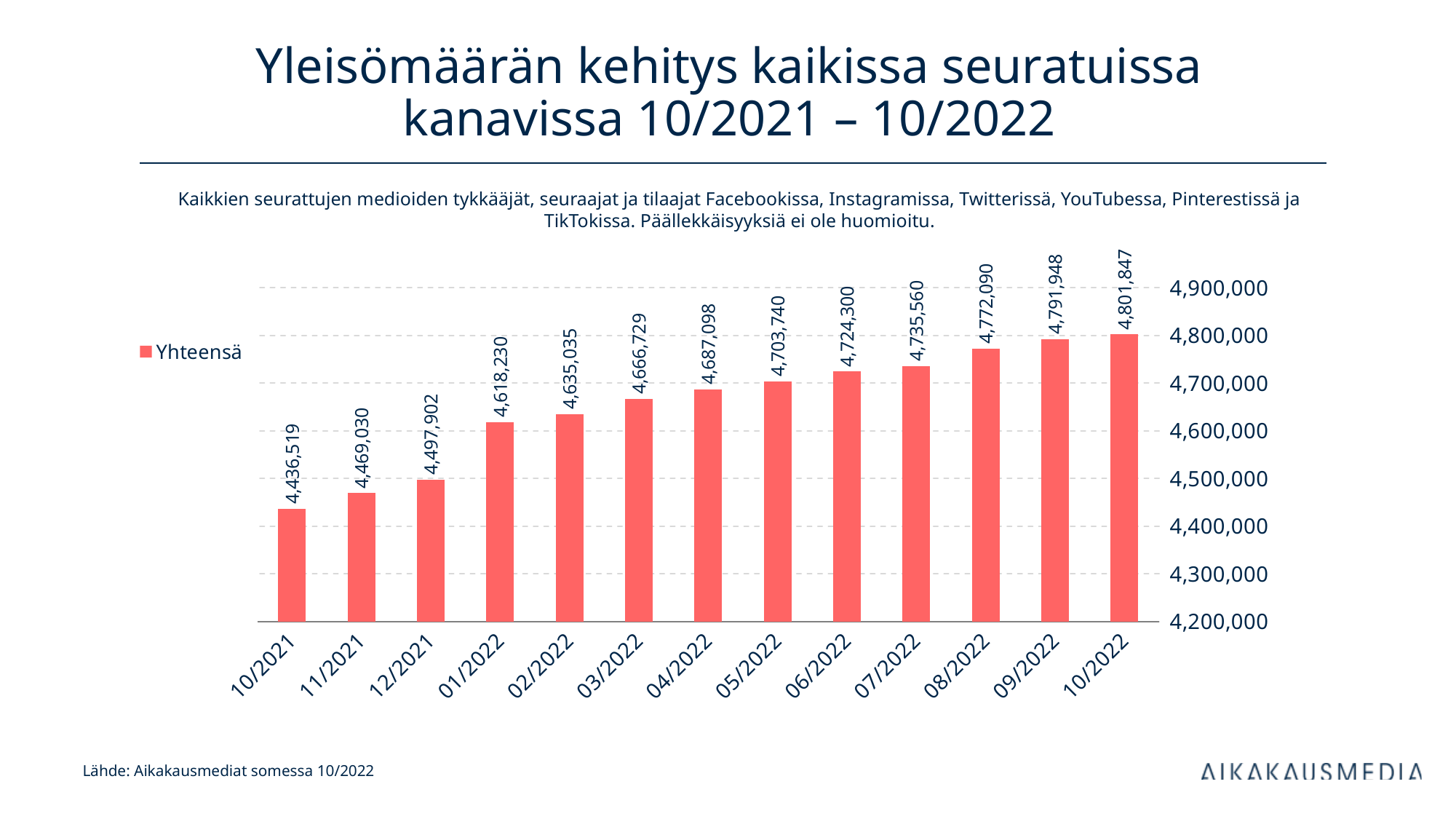
What is the value for 01/2022? 4,618,230 What is the value for 10/2021? 4,436,519 What is the value for 06/2022? 4,724,300 What is the difference between the values for 01/2022 and 12/2021? 120,328 What kind of chart is this? Bar chart Which month has the highest value? 10/2022 Do the values rise or fall from 10/2021 to 10/2022? Rise What is the value for 10/2022? 4,801,847 How many months are shown on the x axis? 13 What is the difference between the values for 10/2022 and 10/2021? 365,328 Which month has the lowest value? 10/2021 Which is larger, the value for 03/2022 or the value for 12/2021? 03/2022